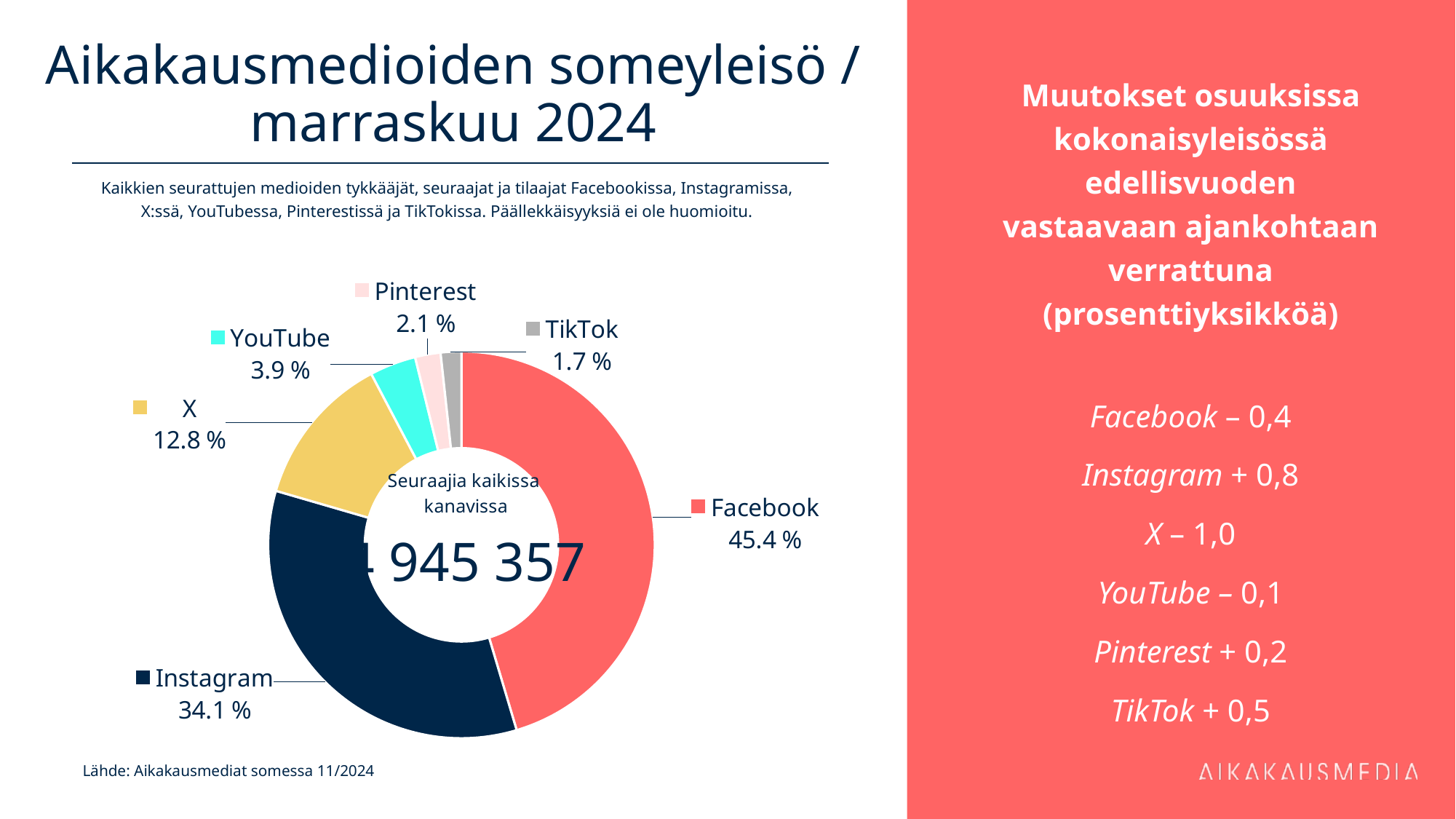
What is the combined share of X and YouTube? 16.7 % Which has a larger share, YouTube or Pinterest? YouTube How many channels are shown in the chart? 6 What colour is the Instagram segment in the chart? Dark navy blue What share does TikTok have? 1.7 % What is the difference in percentage points between Facebook's and Instagram's shares? 11.3 Which channel has the largest share of the audience? Facebook What share of the social media audience does Facebook have? 45.4 % What kind of chart is used on the slide? Donut (pie) chart What is the share shown for X? 12.8 % What share does Instagram have in the donut chart? 34.1 % Which channel has the smallest share of the audience? TikTok